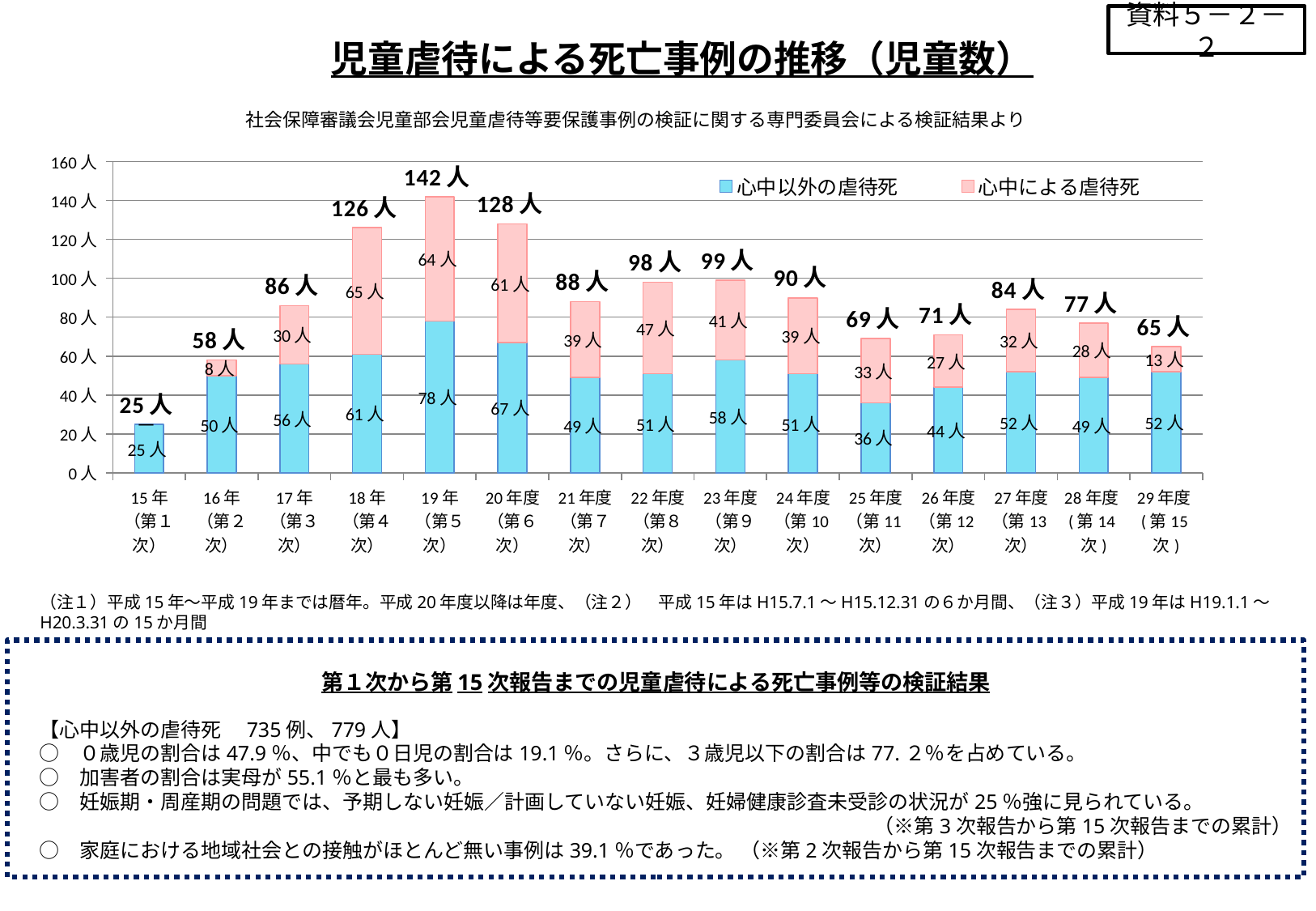
Which year has the lowest total number of children? 15年（第1次） Is the total for 27年度（第13次） greater or less than 80人? greater What is the value of 心中以外の虐待死 for 23年度（第9次）? 58人 What is the total number of children for 19年（第5次）? 142人 What is the value of 心中による虐待死 for 18年（第4次）? 65人 What type of chart is shown on the slide? stacked bar chart Which series is shown in pink in the legend? 心中による虐待死 Which is larger, the 心中以外の虐待死 value for 25年度（第11次） or for 26年度（第12次）? 26年度（第12次） What is the difference between the totals for 19年（第5次） and 20年度（第6次）? 14人 How many series does the legend list? 2 Which year has the highest total number of children? 19年（第5次） How many year categories are shown on the x axis? 15